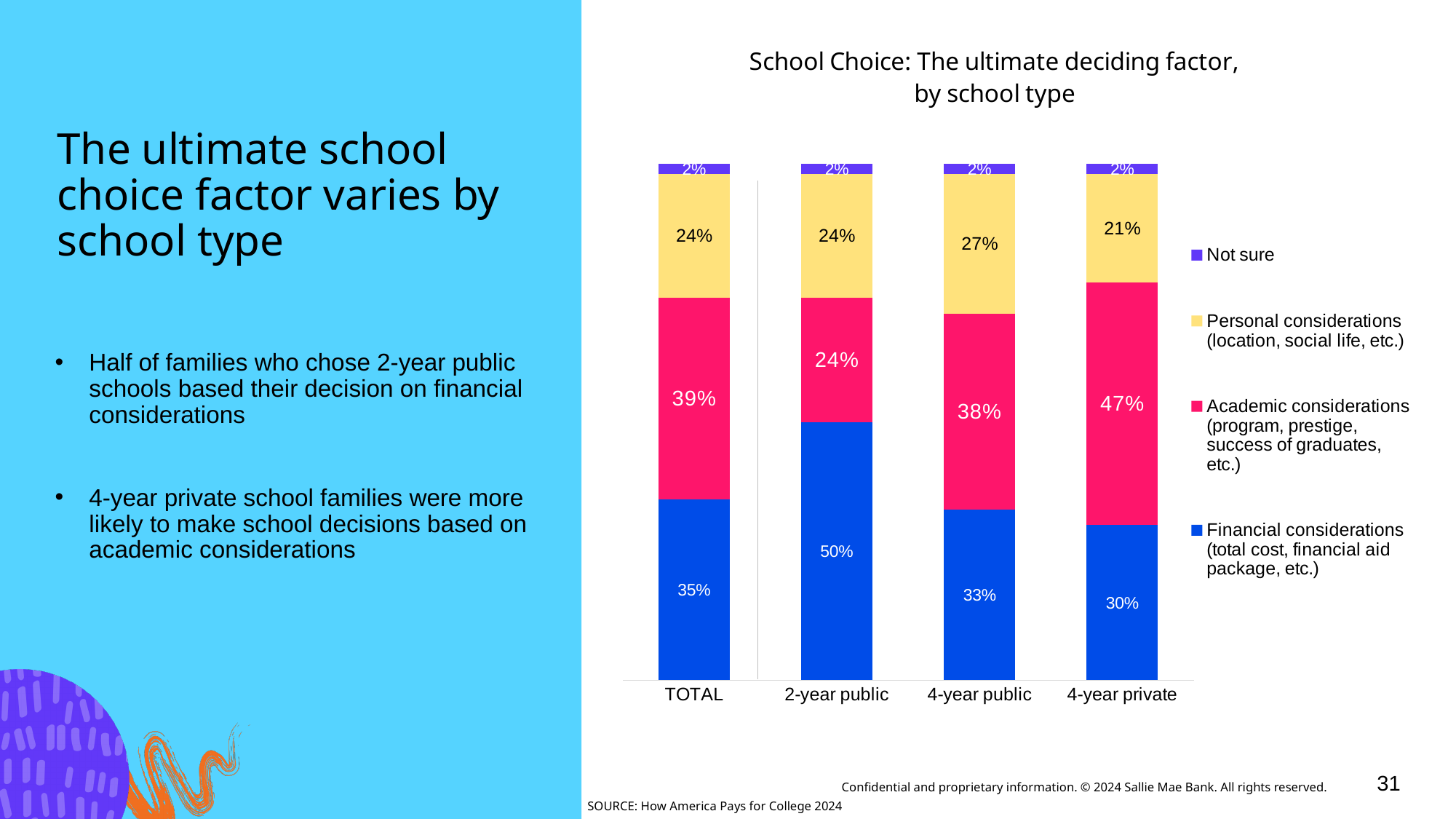
How many school type categories are shown on the x axis? 4 Which school type has the lowest value for academic considerations? 2-year public What is the value for financial considerations in the TOTAL bar? 35% What is the title of the chart? School Choice: The ultimate deciding factor, by school type How many series does the legend list? 4 What percentage of 2-year public school families cited financial considerations as the ultimate deciding factor? 50% What kind of chart is shown on the slide? Stacked bar chart What is the difference between the academic considerations values for 4-year private and 2-year public? 23% Which school type has the highest value for financial considerations? 2-year public What is the value for academic considerations for 4-year private? 47% What is the value for personal considerations for 4-year public? 27% Which is larger: financial considerations for 4-year public or for 4-year private? 4-year public